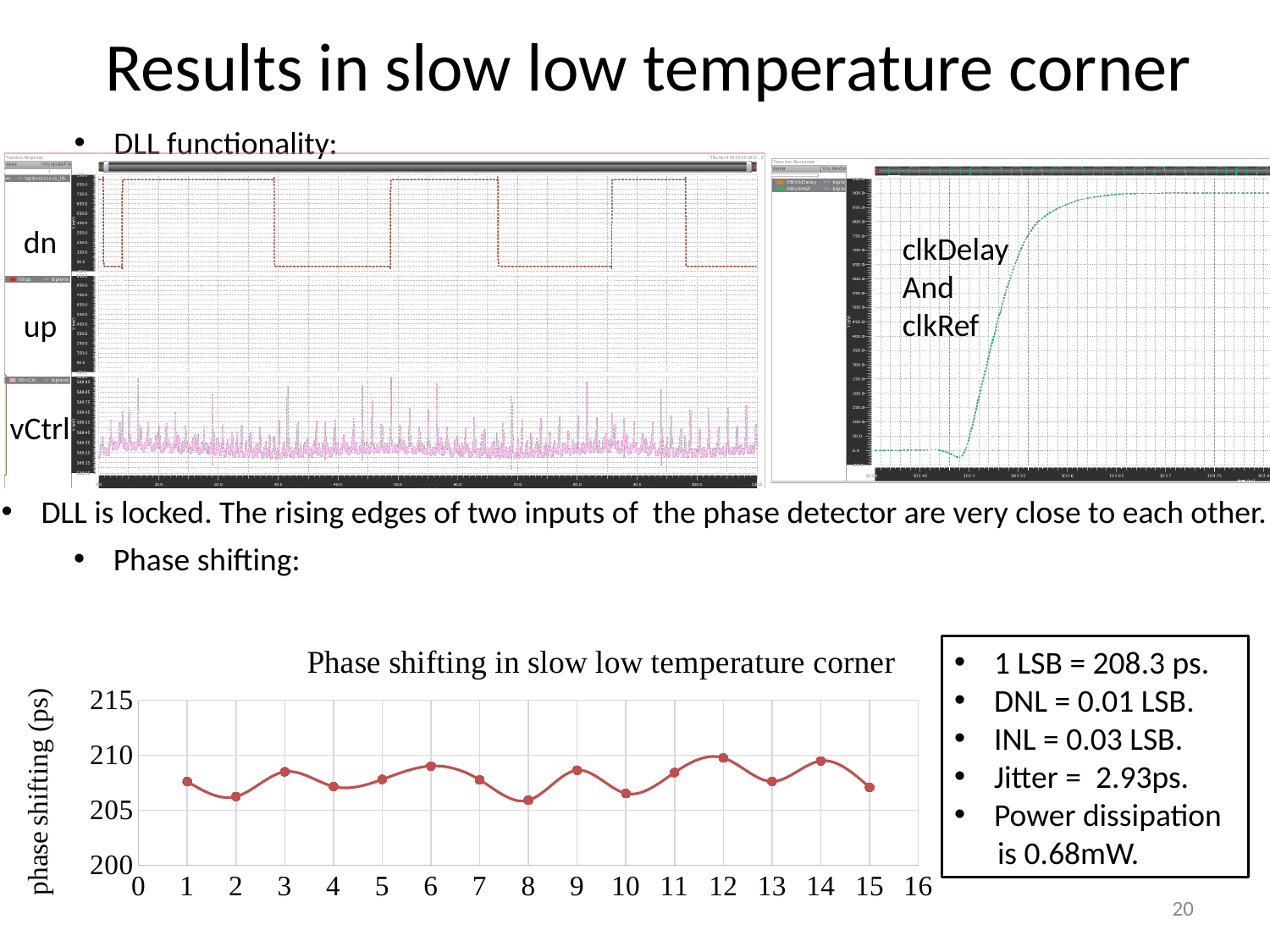
What is the title of the line chart at the bottom of the slide? Phase shifting in slow low temperature corner In the "Phase shifting in slow low temperature corner" chart, is the value at x = 2 greater or less than 210? less In the "Phase shifting in slow low temperature corner" chart, is the value at x = 6 greater or less than 205? greater In the "Phase shifting in slow low temperature corner" chart, is the value at x = 12 greater or less than 205? greater In the "Phase shifting in slow low temperature corner" chart, which has the larger value, x = 14 or x = 10? x = 14 What kind of chart is "Phase shifting in slow low temperature corner"? line chart In the "Phase shifting in slow low temperature corner" chart, which has the larger value, x = 6 or x = 2? x = 6 In the "Phase shifting in slow low temperature corner" chart, do the values show a steady rise, a steady fall, or fluctuate along the x axis? fluctuate What is the y-axis label of the "Phase shifting in slow low temperature corner" chart? phase shifting (ps) How many data points are plotted in the "Phase shifting in slow low temperature corner" chart? 15 In the "Phase shifting in slow low temperature corner" chart, which has the larger value, x = 12 or x = 8? x = 12